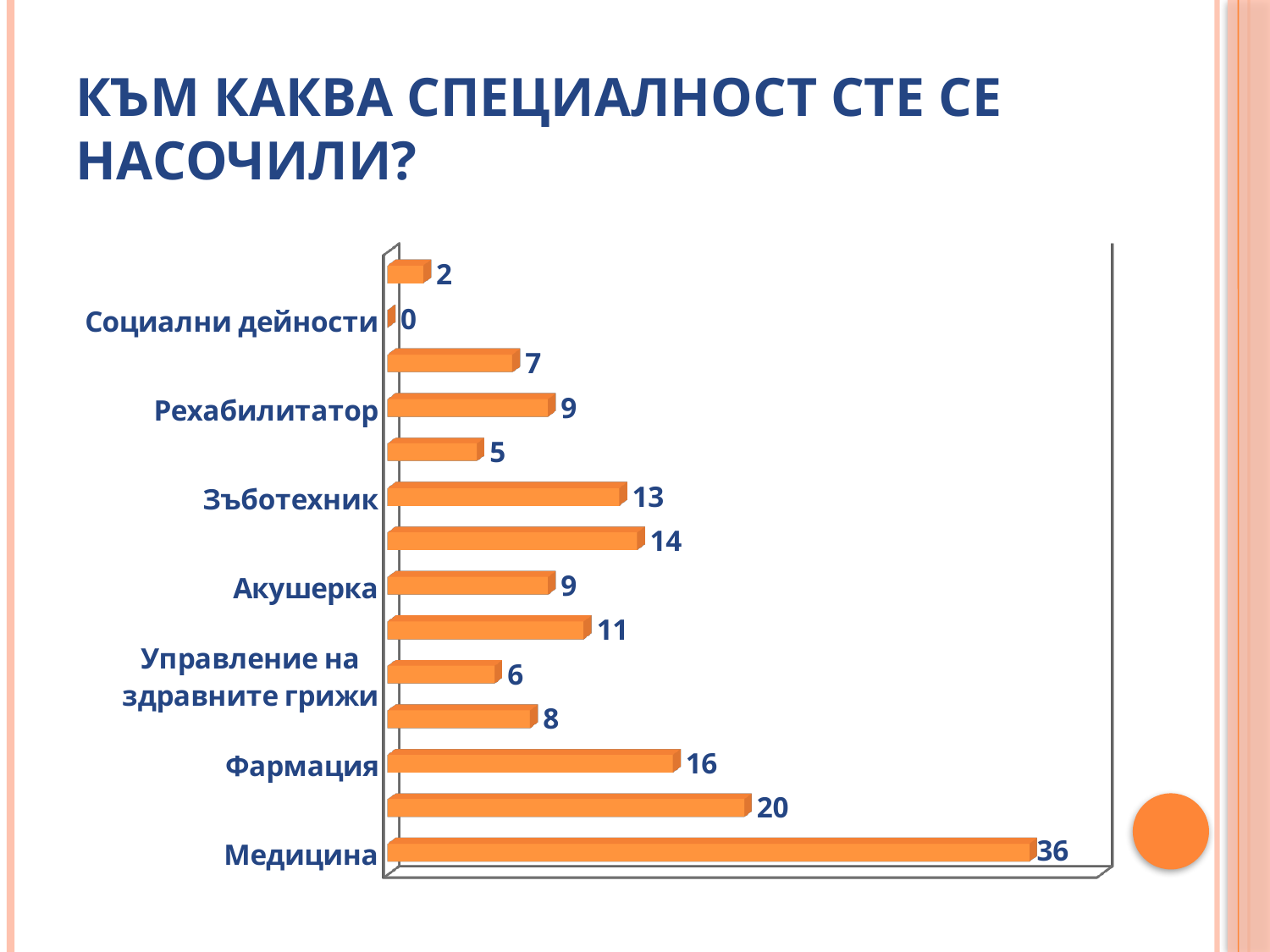
What is the difference between the values for Медицина and Фармация? 20 What value is shown for Медицина? 36 What value is shown for Управление на здравните грижи? 6 What value is shown for Зъботехник? 13 What value is shown for Фармация? 16 Which is larger, the value for Фармация or the value for Зъботехник? Фармация What kind of chart is shown on the slide? Bar chart What value is shown for Социални дейности? 0 Which category has the highest value? Медицина What is the difference between the values for Зъботехник and Акушерка? 4 How many bars are plotted in the chart? 14 Which category has the lowest value? Социални дейности